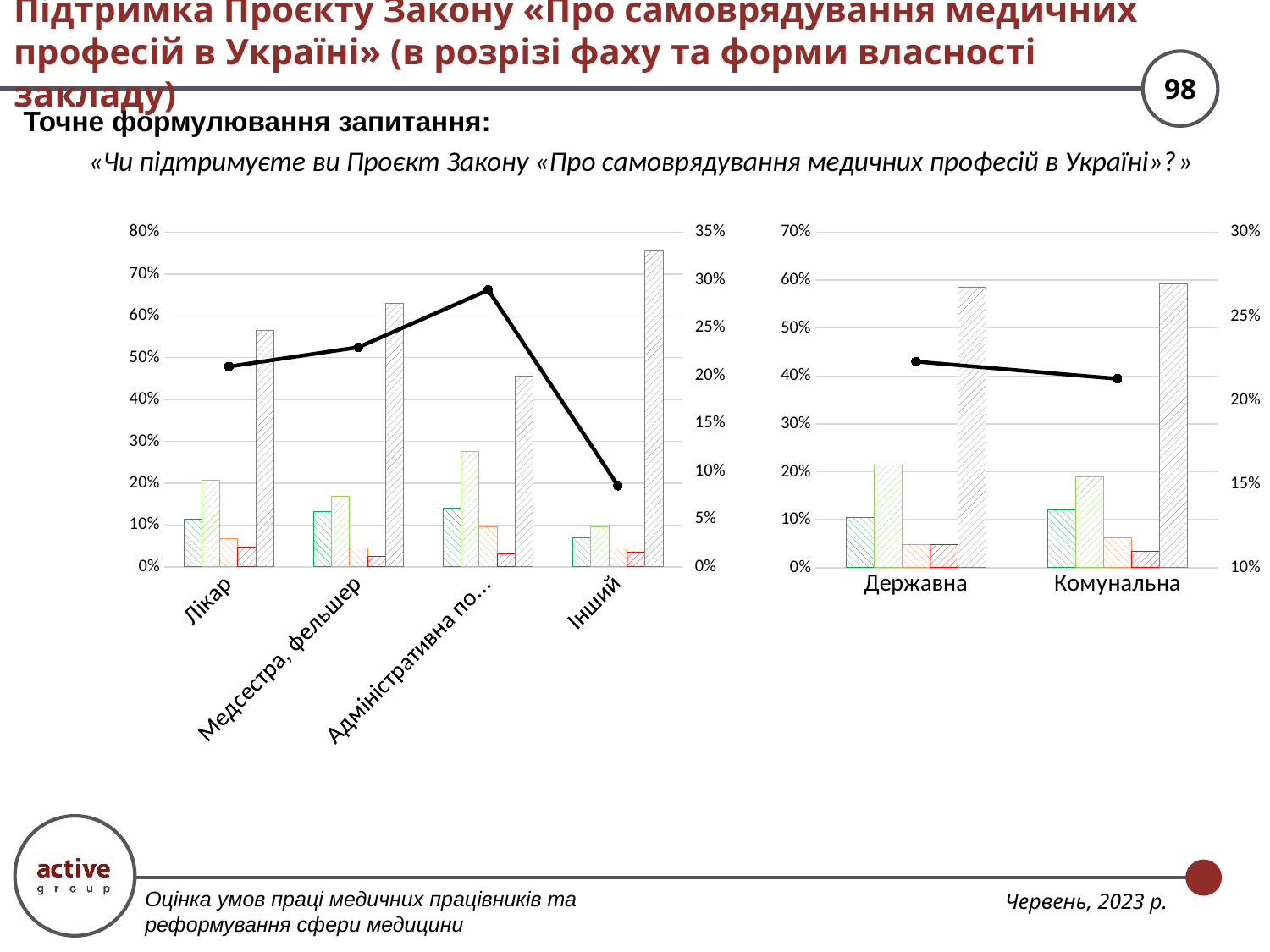
How many categories are shown on the x axis of the left chart? 4 What kind of chart is the left chart on the slide? Combination bar and line chart How many categories are shown on the x axis of the right chart? 2 In the left chart, is the line value for Адміністративна по… (right axis) greater or less than 25%? greater In the left chart, for which category is the tallest grey hatched bar the highest? Інший In the right chart, does the line rise or fall from Державна to Комунальна? fall In the left chart, is the grey hatched bar for Інший (left axis) greater or less than 70%? greater In the left chart, for which category does the line reach its highest point? Адміністративна по… In the left chart, for which category does the line reach its lowest point? Інший What are the two categories on the x axis of the right chart? Державна, Комунальна In the right chart, is the line value for Державна (right axis) greater or less than 25%? less